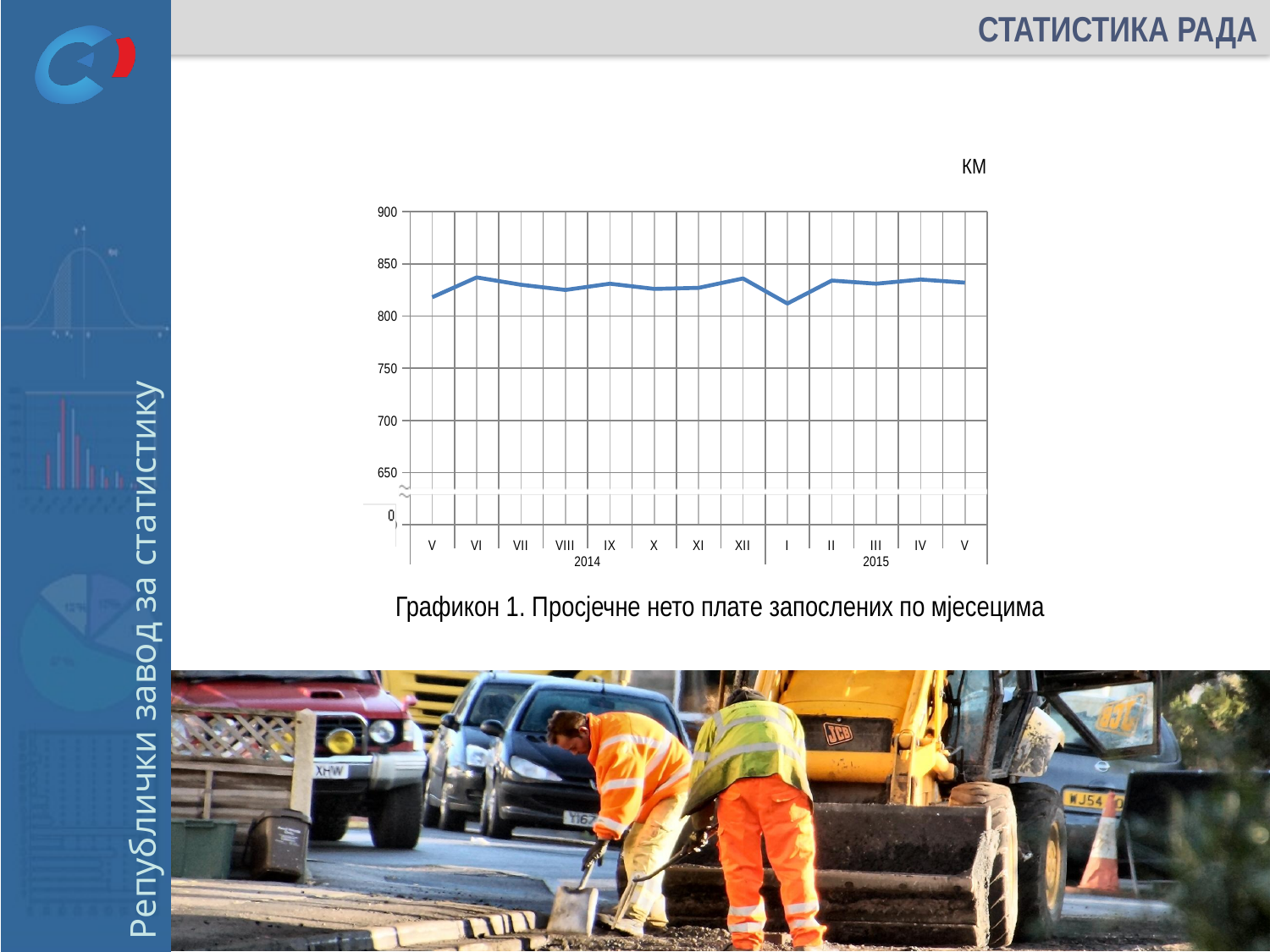
What kind of chart is shown on the slide? line chart Is the value for I 2015 greater or less than 800? greater Is the value for V 2015 greater or less than 800? greater Is the value for VI 2014 greater or less than 850? less Does the line rise or fall from I 2015 to II 2015? rise Which month has the lowest average net wage on the chart? I 2015 Does the line rise or fall from XII 2014 to I 2015? fall What is the title of the chart on the slide? Графикон 1. Просјечне нето плате запослених по мјесецима How many monthly data points are plotted on the chart? 13 Which is larger, the value for VI 2014 or the value for I 2015? VI 2014 What unit is indicated above the chart? KM Which is larger, the value for XII 2014 or the value for V 2014? XII 2014